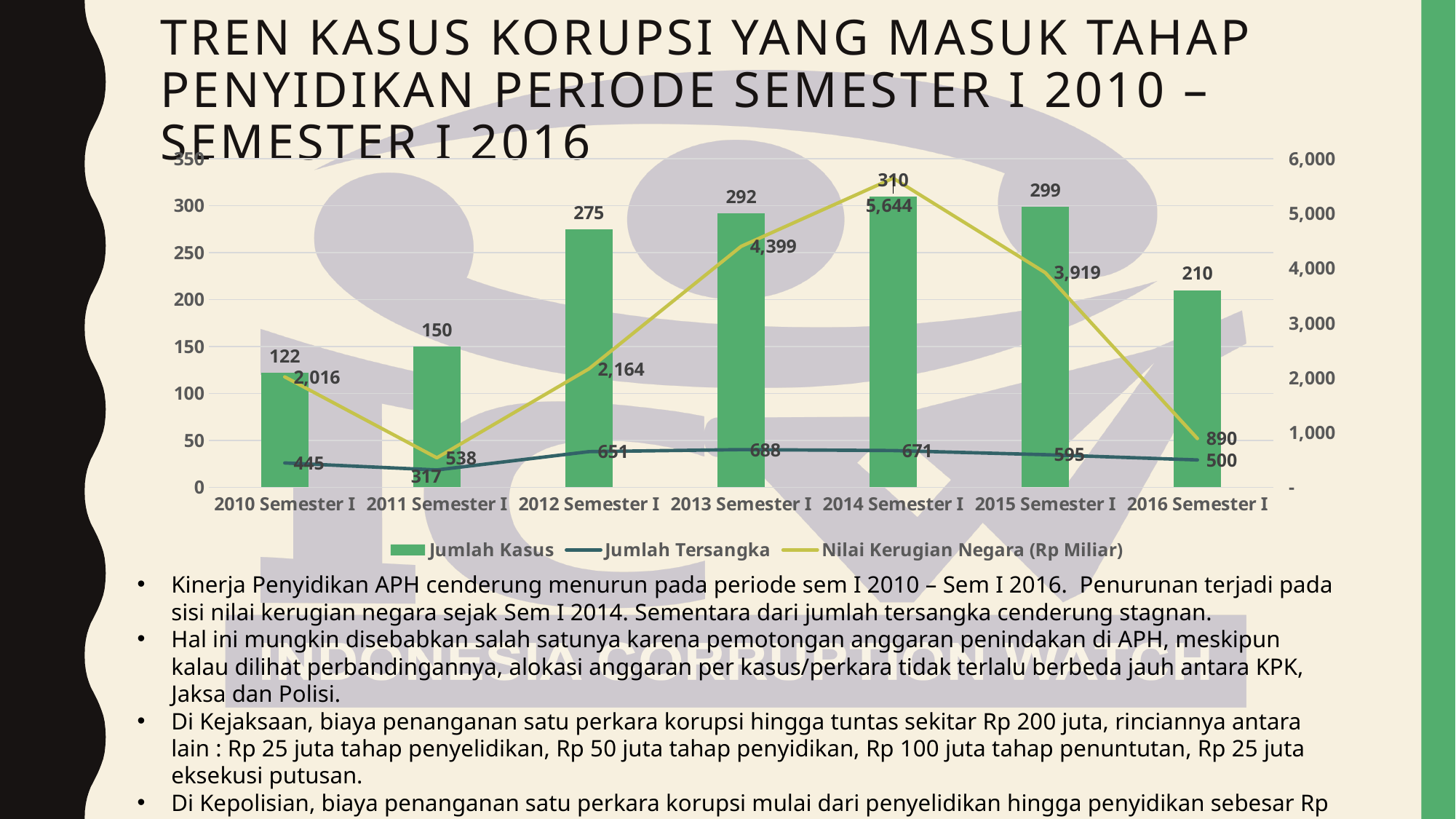
What is the difference in Jumlah Kasus between 2014 Semester I and 2016 Semester I? 100 Does the Nilai Kerugian Negara (Rp Miliar) rise or fall from 2014 Semester I to 2016 Semester I? Fall What is the Nilai Kerugian Negara (Rp Miliar) value for 2014 Semester I? 5,644 What is the Jumlah Kasus value for 2012 Semester I? 275 What kind of chart is this? Combination bar and line chart How many periods are shown on the x axis? 7 What is the Jumlah Tersangka value for 2013 Semester I? 688 Which is larger, the Nilai Kerugian Negara for 2013 Semester I or for 2015 Semester I? 2013 Semester I Which period has the highest Jumlah Kasus? 2014 Semester I Which period has the lowest Jumlah Tersangka? 2011 Semester I How many series does the legend list? 3 Which period has the lowest Nilai Kerugian Negara (Rp Miliar)? 2011 Semester I